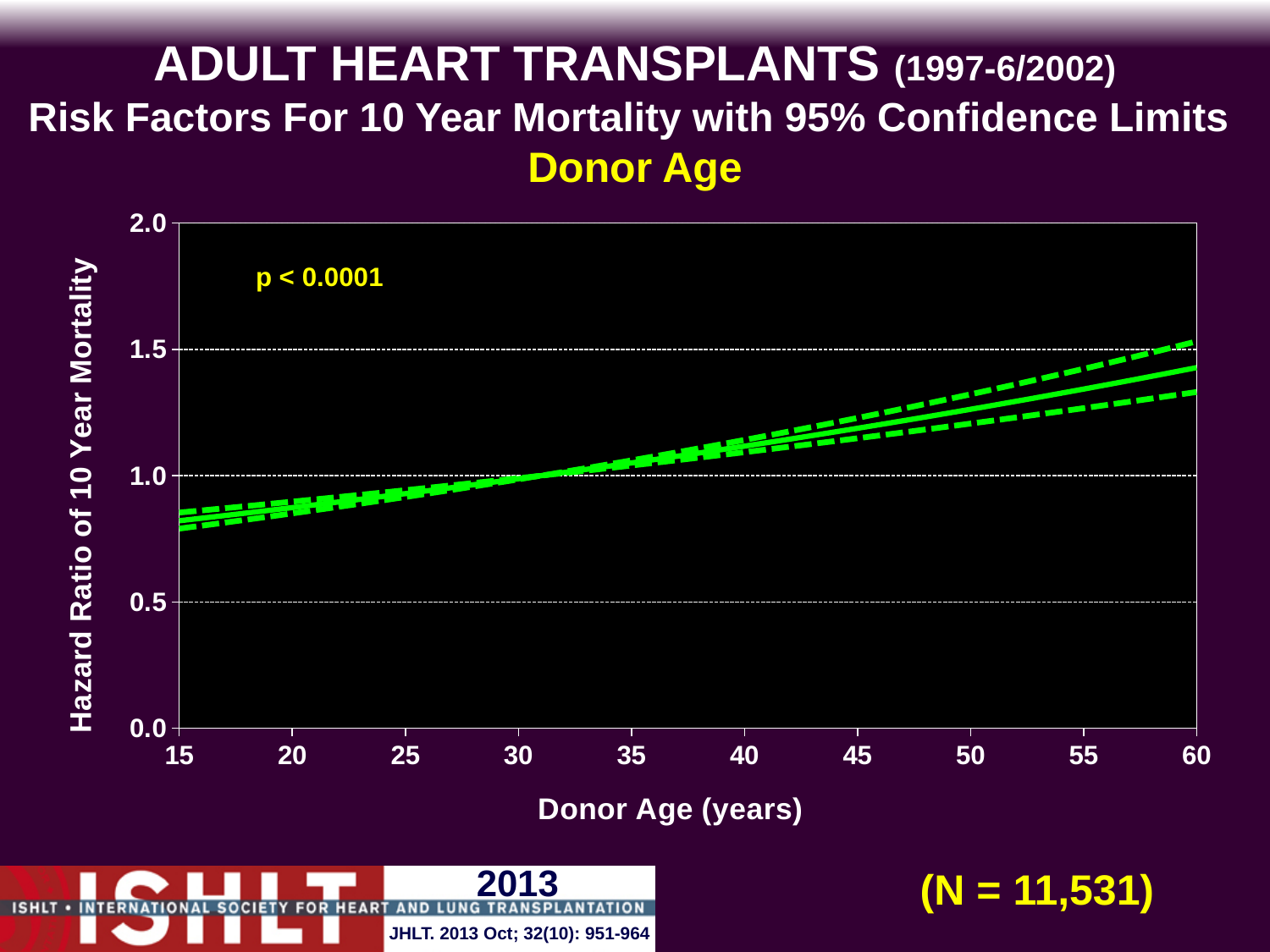
Does the hazard ratio of 10 year mortality rise or fall as donor age increases? rise What kind of chart is shown on the slide? line chart How many lines are plotted on the chart? 3 What is the label of the x axis? Donor Age (years) Is the hazard ratio (solid line) for a donor age of 60 years greater or less than 1.5? less What p-value is printed on the chart? p < 0.0001 Is the hazard ratio for a donor age of 60 years greater or less than 1.0? greater Which donor age has the higher hazard ratio, 20 years or 50 years? 50 years Is the hazard ratio for a donor age of 15 years greater or less than 1.0? less